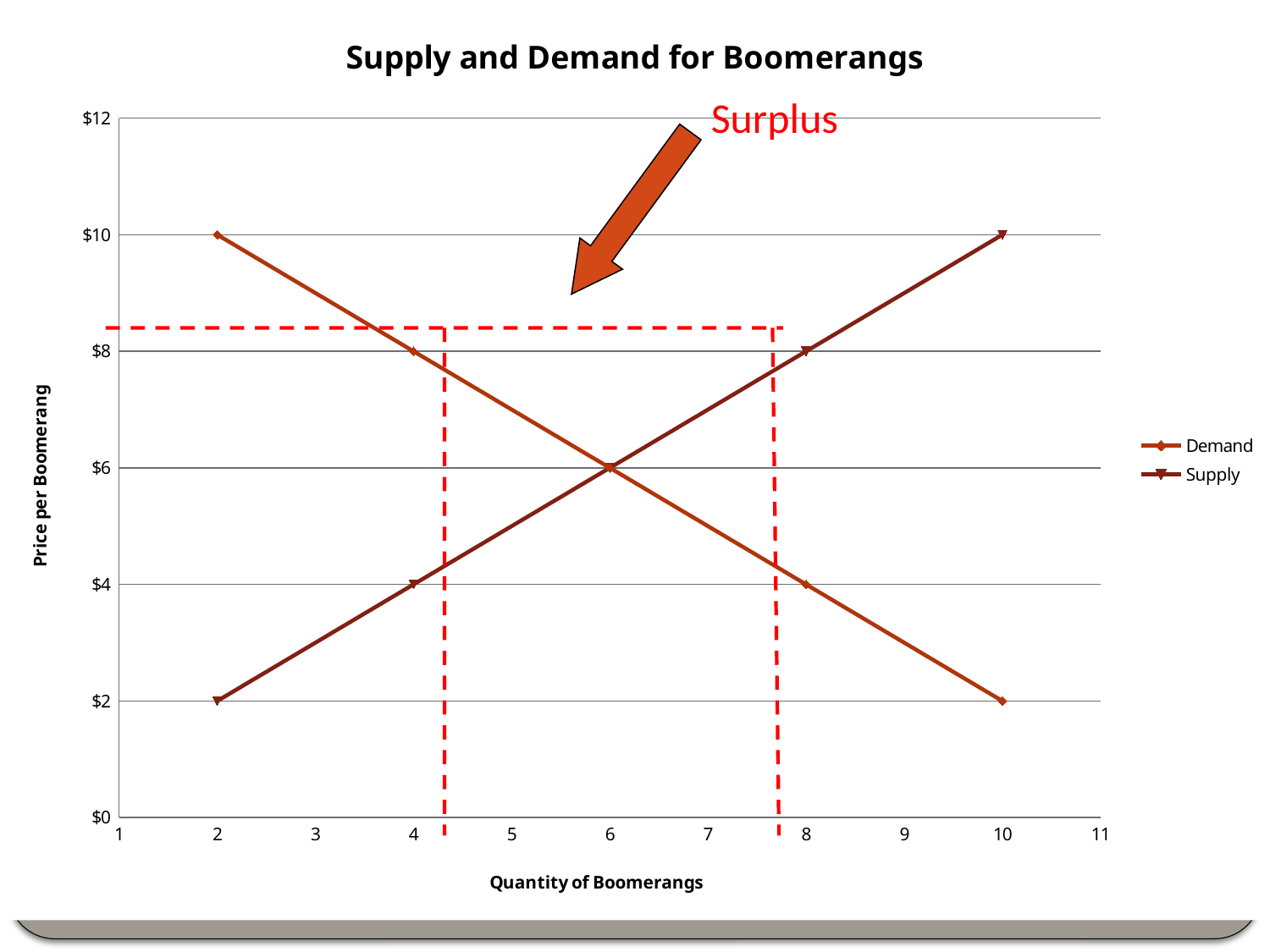
How many series does the legend list? 2 What is the difference between the Demand price and the Supply price at a quantity of 4 boomerangs? $4 What is the price on the Demand line at a quantity of 2 boomerangs? $10 At what quantity do the Demand and Supply lines intersect? 6 Does the Demand line rise or fall as quantity increases? fall Does the Supply line rise or fall as quantity increases? rise What is the price on the Supply line at a quantity of 2 boomerangs? $2 What is the title of the chart? Supply and Demand for Boomerangs At a quantity of 8 boomerangs, which is higher, the Supply price or the Demand price? Supply What is the price on the Supply line at a quantity of 10 boomerangs? $10 What is the price at which the Demand and Supply lines intersect? $6 What kind of chart is shown on the slide? line chart